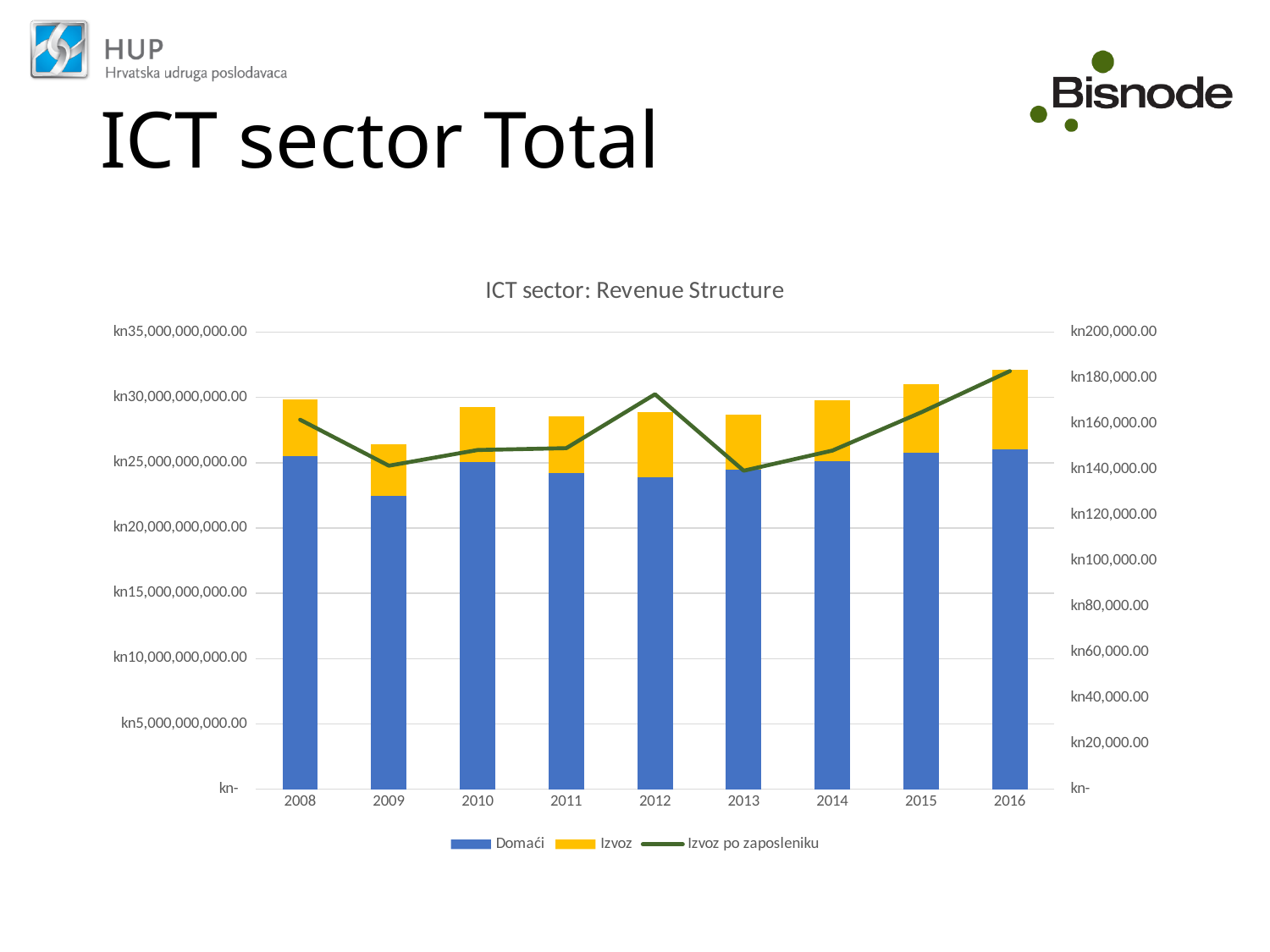
In which year is the total stacked bar (Domaći plus Izvoz) the lowest? 2009 Is the total stacked bar for 2016 greater or less than kn30,000,000,000.00? greater What is the title of the chart? ICT sector: Revenue Structure How many years are shown on the x axis? 9 What kind of chart is shown on the slide? bar chart with a line Is the Domaći value for 2009 greater or less than kn25,000,000,000.00? less In which year does the Izvoz po zaposleniku line reach its highest point? 2016 In which year is the total stacked bar (Domaći plus Izvoz) the highest? 2016 Is the Izvoz po zaposleniku value for 2013 greater or less than kn160,000.00? less Which year has the higher Izvoz po zaposleniku value, 2012 or 2013? 2012 Which series is plotted as a line rather than bars? Izvoz po zaposleniku How many series does the legend list? 3